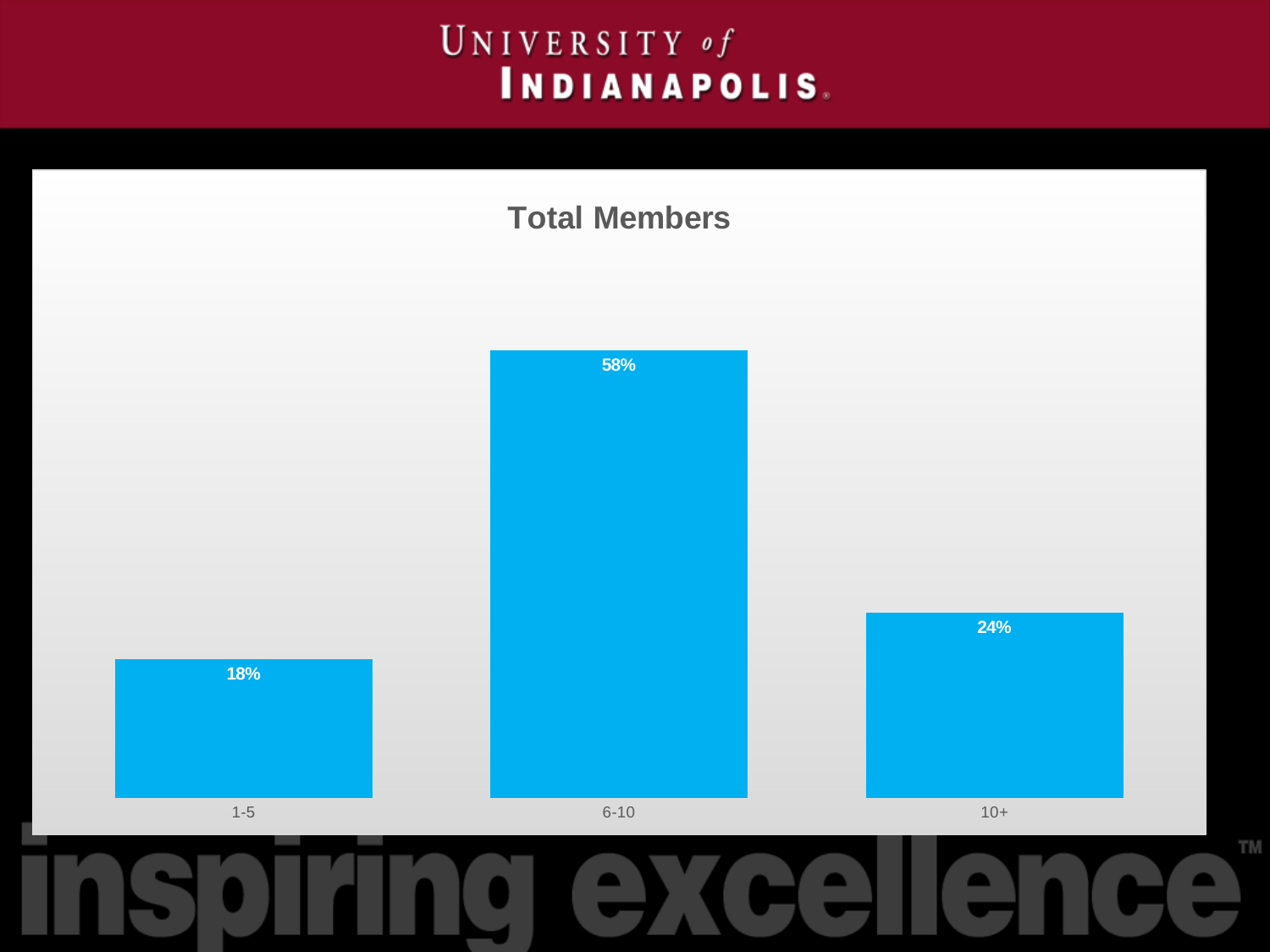
How many categories are shown in the chart? 3 Which is larger, the value for 1-5 or the value for 10+? 10+ What is the difference between the values for 10+ and 1-5? 6% Which category has the lowest value? 1-5 What is the value for the 1-5 category? 18% Which category has the highest value? 6-10 What is the title of the chart? Total Members What is the value for the 6-10 category? 58% What is the value for the 10+ category? 24% What is the difference between the values for 6-10 and 10+? 34% What colour are the bars in the chart? blue What kind of chart is shown on the slide? bar chart